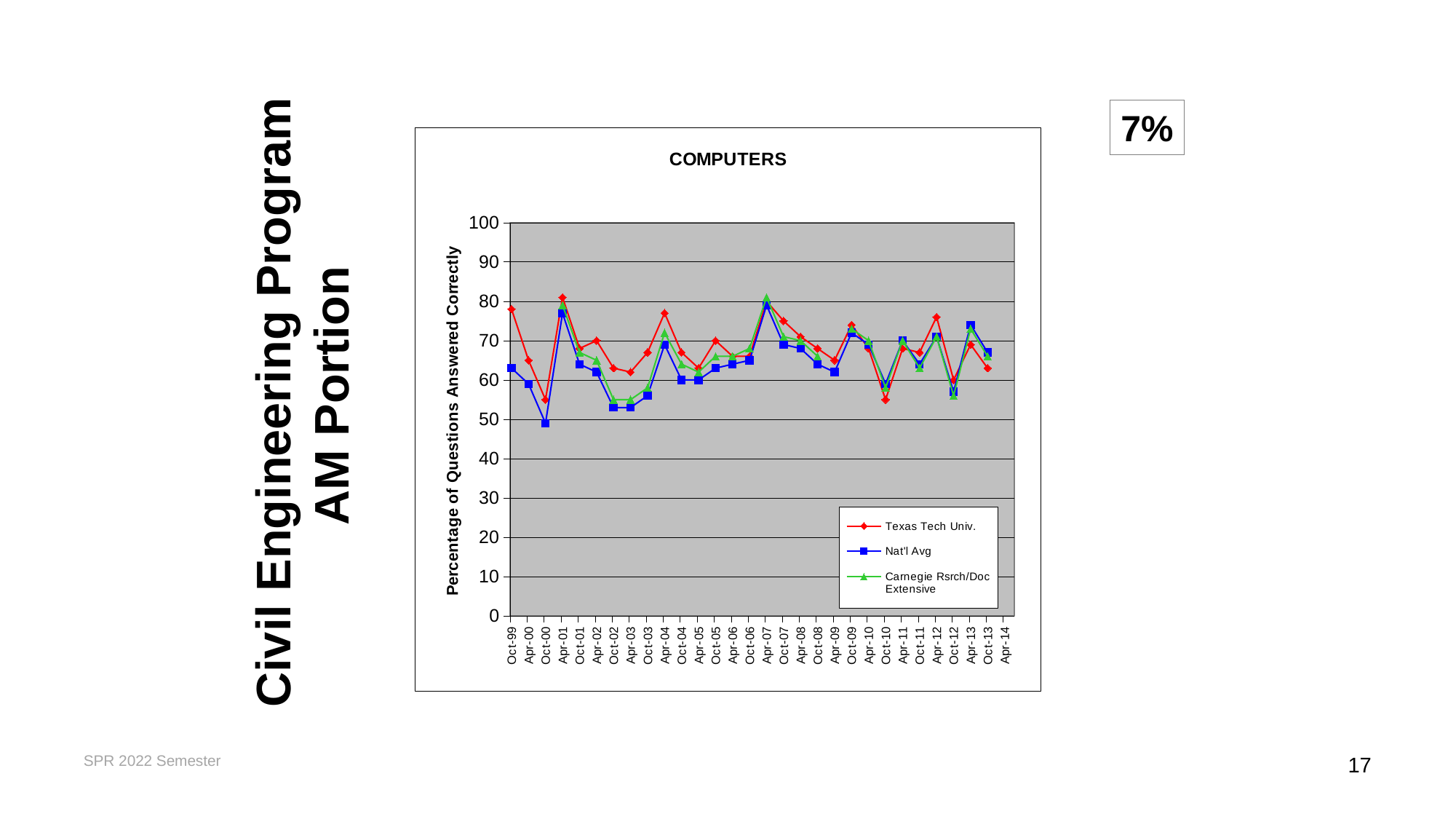
Is the value for Texas Tech Univ. at Oct-99 greater or less than 70? greater What is the title of the chart? COMPUTERS At which date does the Nat'l Avg series reach its lowest value? Oct-00 At Apr-13, which is higher: Texas Tech Univ. or Nat'l Avg? Nat'l Avg Is the value for Texas Tech Univ. at Oct-10 greater or less than 60? less Does the Texas Tech Univ. series rise or fall between Oct-99 and Oct-00? fall What is the label on the vertical axis of the chart? Percentage of Questions Answered Correctly Is the value for Nat'l Avg at Oct-02 greater or less than 60? less What kind of chart is shown on the slide? line chart How many series does the chart's legend list? 3 At Oct-99, which is higher: Texas Tech Univ. or Nat'l Avg? Texas Tech Univ.